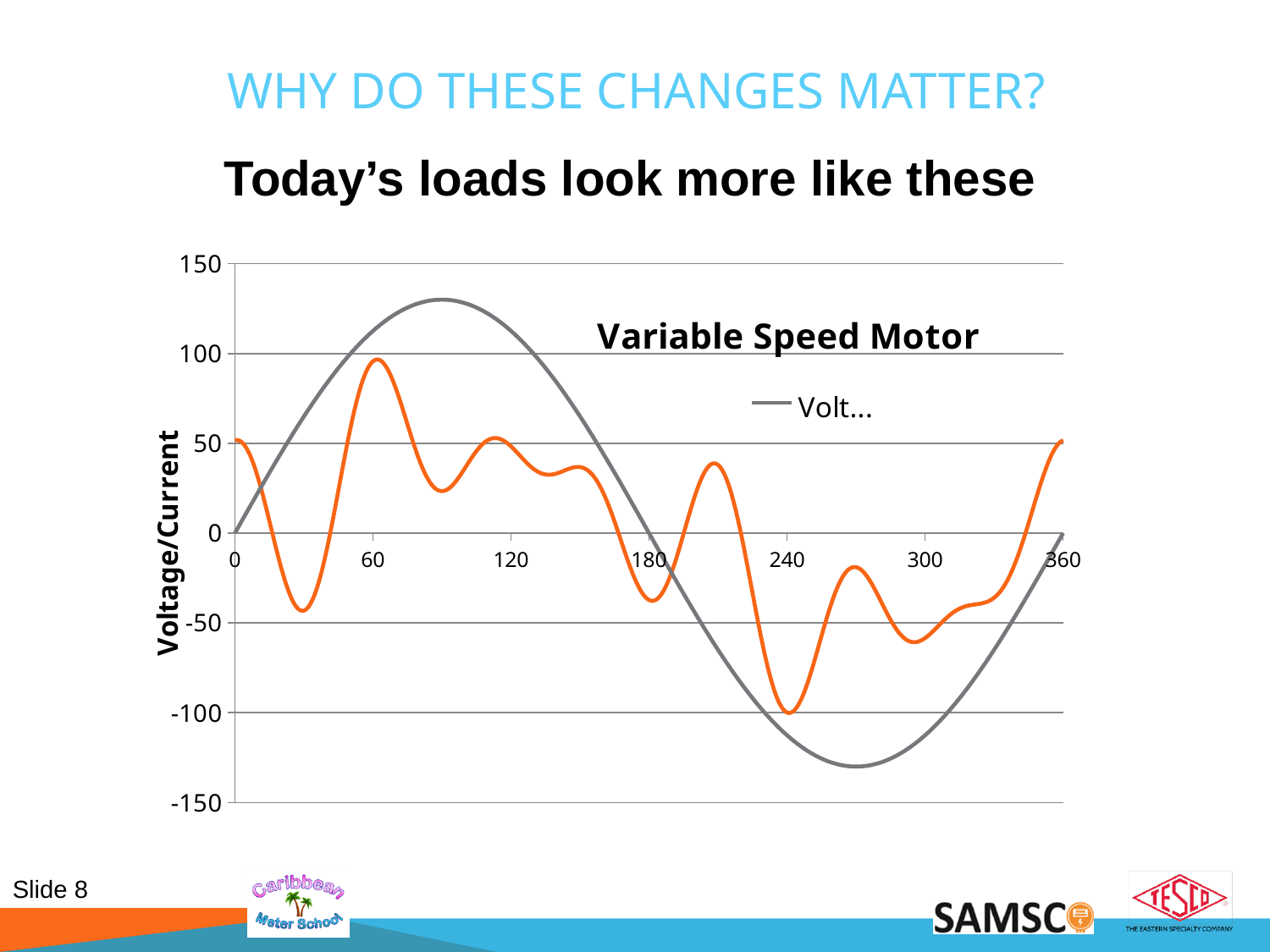
Does the grey line rise or fall between x = 90 and x = 270? fall Is the value of the orange line at x = 30 greater or less than 0? less Is the value of the orange line at x = 210 greater or less than 0? greater What kind of chart is shown on the slide? line chart How many lines are plotted on the chart? 2 What is the title of the chart? Variable Speed Motor How many series does the chart's legend list? 1 What is the value of the grey line at x = 180? 0 Is the value of the grey line at x = 90 greater or less than 100? greater What is the label on the vertical axis of the chart? Voltage/Current At x = 90, which line has the higher value, the grey line or the orange line? the grey line